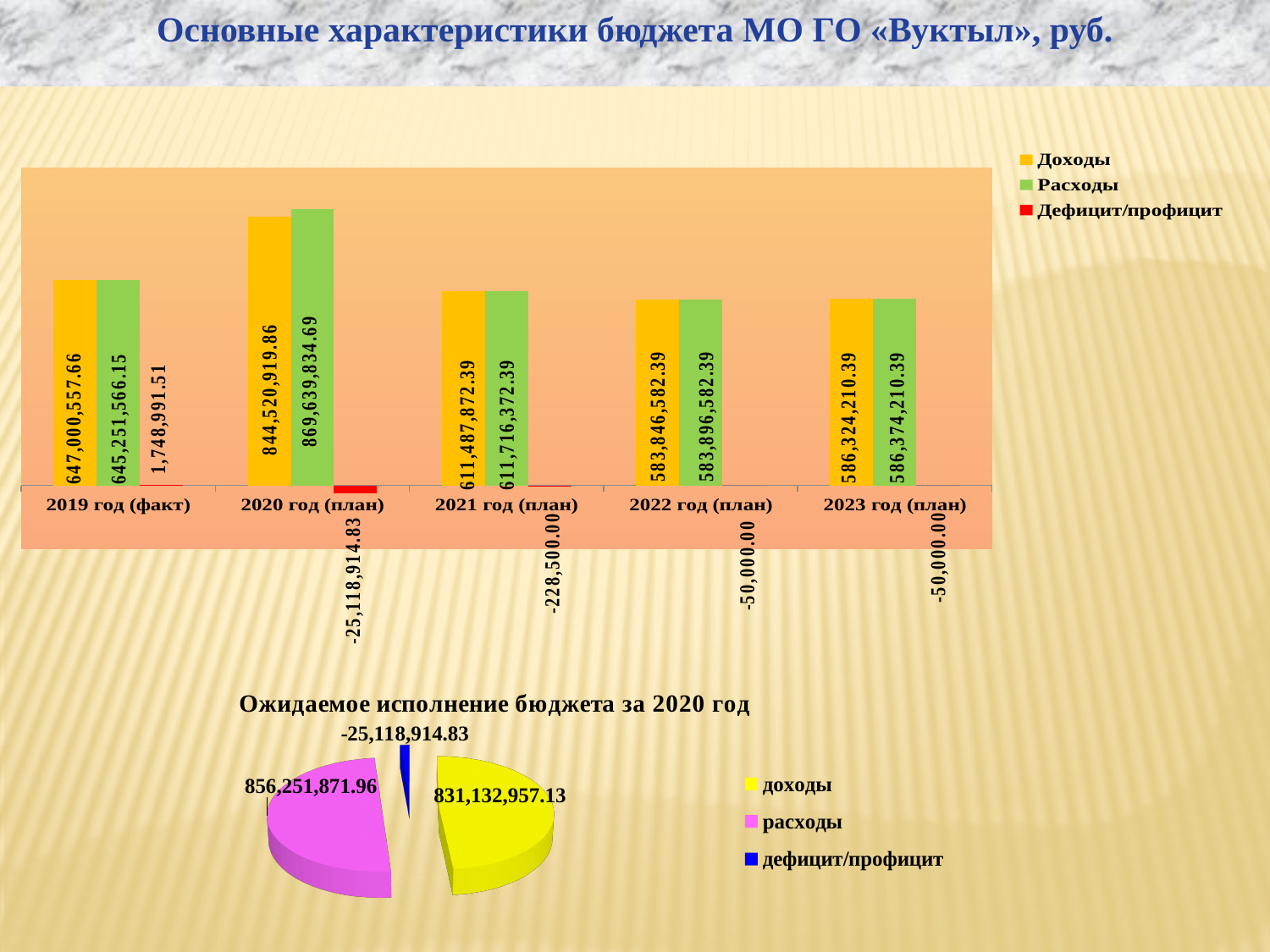
How many series does the legend of the top bar chart list? 3 How many categories are shown on the x axis of the top bar chart? 5 In the top bar chart, what is the value of Доходы for 2020 год (план)? 844,520,919.86 In the top bar chart, which category has the lowest Доходы value? 2022 год (план) In the top bar chart, which category has the highest Расходы value? 2020 год (план) In the bottom pie chart, what is the value of расходы? 856,251,871.96 In the top bar chart, which is larger for 2019 год (факт): Доходы or Расходы? Доходы In the top bar chart, what is the Дефицит/профицит value for 2021 год (план)? -228,500.00 In the bottom pie chart, which colour represents доходы? Yellow What kind of chart is the bottom chart titled 'Ожидаемое исполнение бюджета за 2020 год'? Pie chart In the top bar chart, what is the value of Расходы for 2019 год (факт)? 645,251,566.15 In the top bar chart, what is the difference between Расходы and Доходы for 2020 год (план)? 25,118,914.83